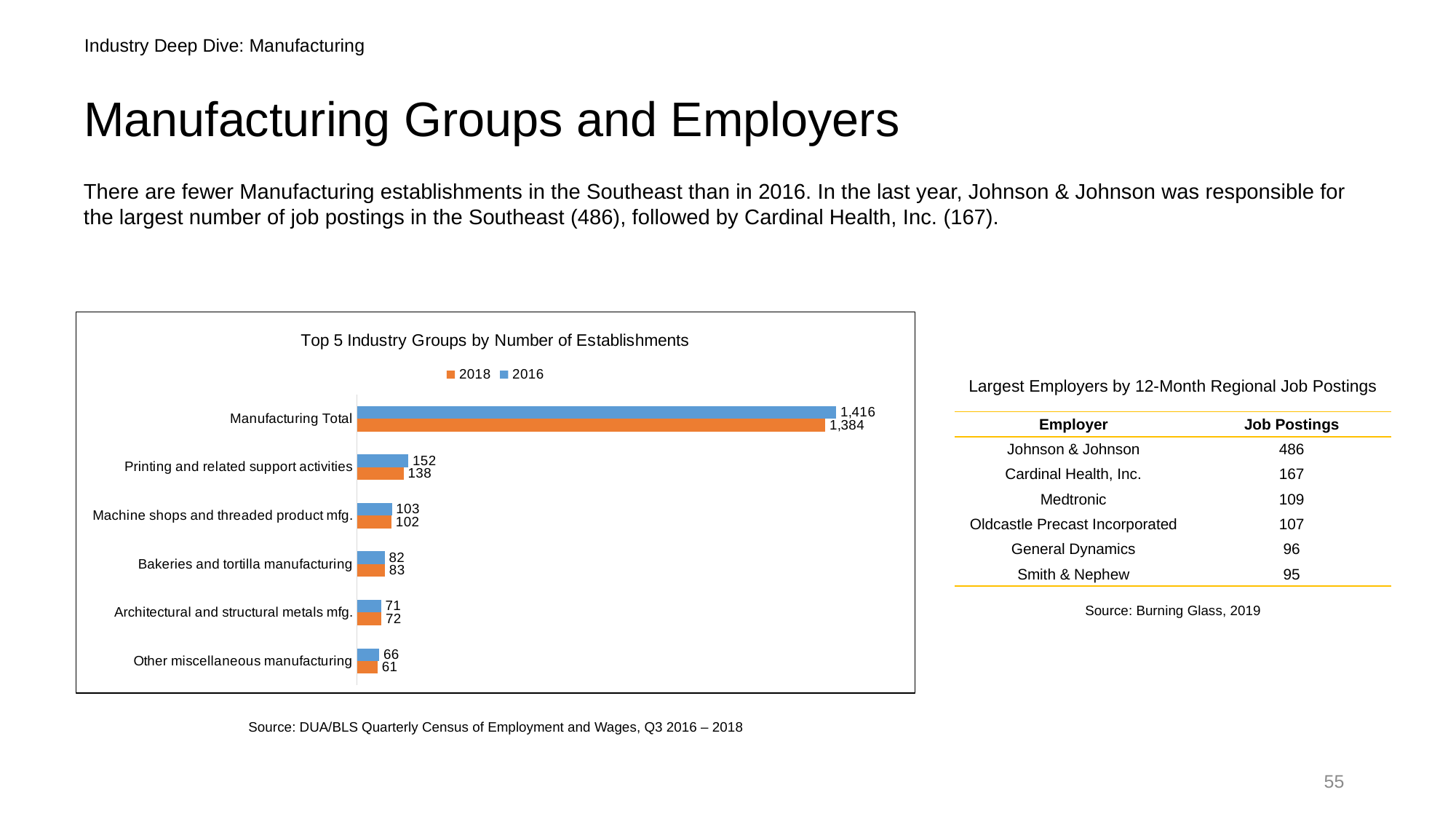
What is the 2018 value for Printing and related support activities in the "Top 5 Industry Groups by Number of Establishments" chart? 138 In the "Top 5 Industry Groups by Number of Establishments" chart, which colour represents the 2018 series? Orange In the "Top 5 Industry Groups by Number of Establishments" chart, which category has the lowest 2018 value? Other miscellaneous manufacturing In the "Top 5 Industry Groups by Number of Establishments" chart, what is the difference between the 2016 and 2018 values for Printing and related support activities? 14 What is the 2016 value for Bakeries and tortilla manufacturing in the "Top 5 Industry Groups by Number of Establishments" chart? 82 In the "Top 5 Industry Groups by Number of Establishments" chart, what is the difference between the 2016 and 2018 values for Manufacturing Total? 32 In the "Top 5 Industry Groups by Number of Establishments" chart, which industry group (excluding Manufacturing Total) has the highest 2018 value? Printing and related support activities What is the 2016 value for Manufacturing Total in the "Top 5 Industry Groups by Number of Establishments" chart? 1,416 How many categories are shown on the "Top 5 Industry Groups by Number of Establishments" chart? 6 What type of chart is "Top 5 Industry Groups by Number of Establishments"? Bar chart What is the 2018 value for Other miscellaneous manufacturing in the "Top 5 Industry Groups by Number of Establishments" chart? 61 How many series does the legend of the "Top 5 Industry Groups by Number of Establishments" chart list? 2